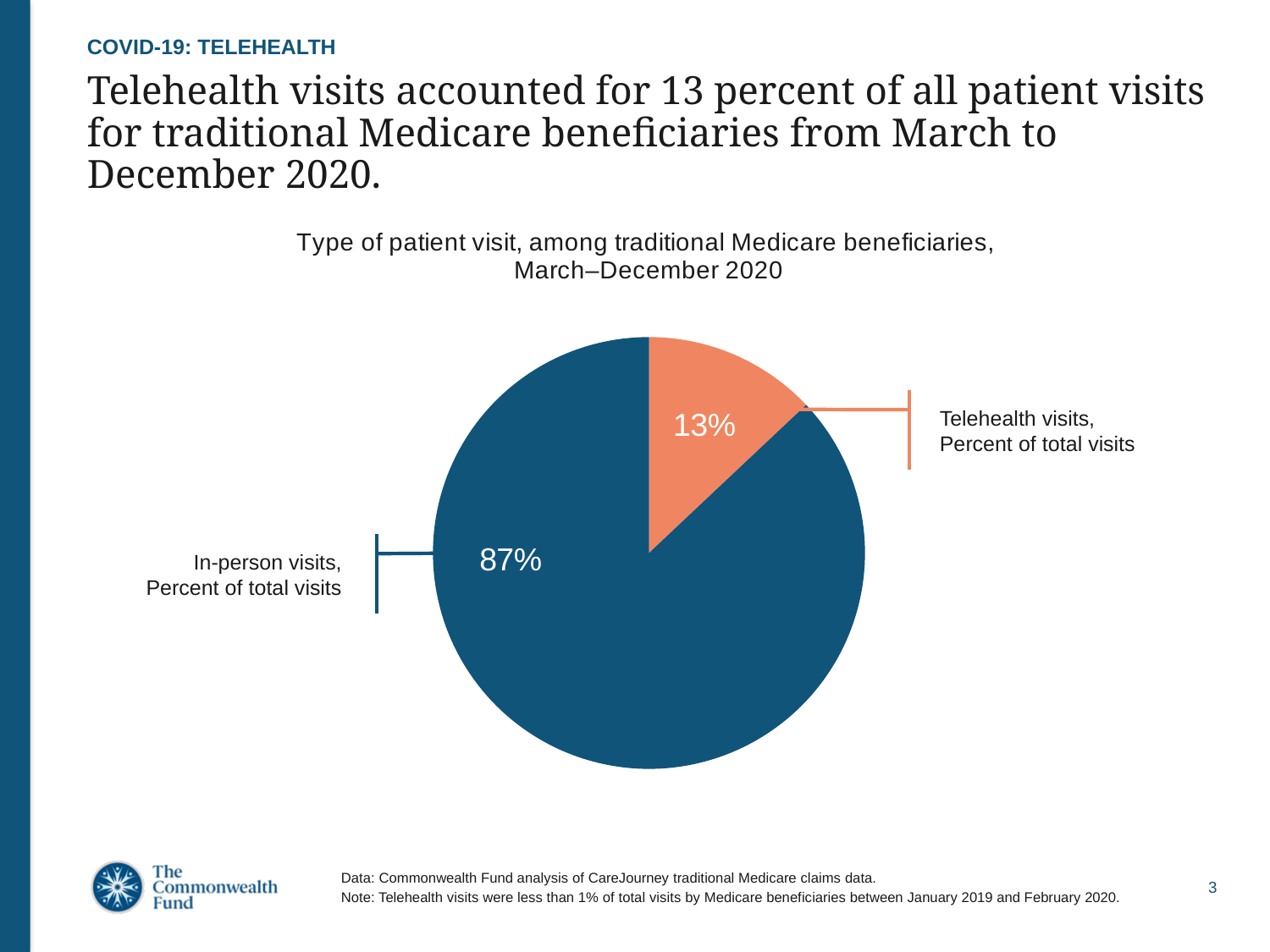
Which is larger: the share of in-person visits or the share of telehealth visits? In-person visits How many slices does the pie chart have? 2 What is the difference in percentage points between in-person visits and telehealth visits? 74 What is the title of the chart? Type of patient visit, among traditional Medicare beneficiaries, March–December 2020 What percentage of total visits were telehealth visits? 13% What colour is the slice representing telehealth visits? Orange Which type of visit accounts for the smallest share of the pie? Telehealth visits Which type of visit accounts for the largest share of the pie? In-person visits What is the share of the pie taken by the telehealth visits slice? 13% What kind of chart is shown on the slide? Pie chart What percentage of total visits were in-person visits? 87%